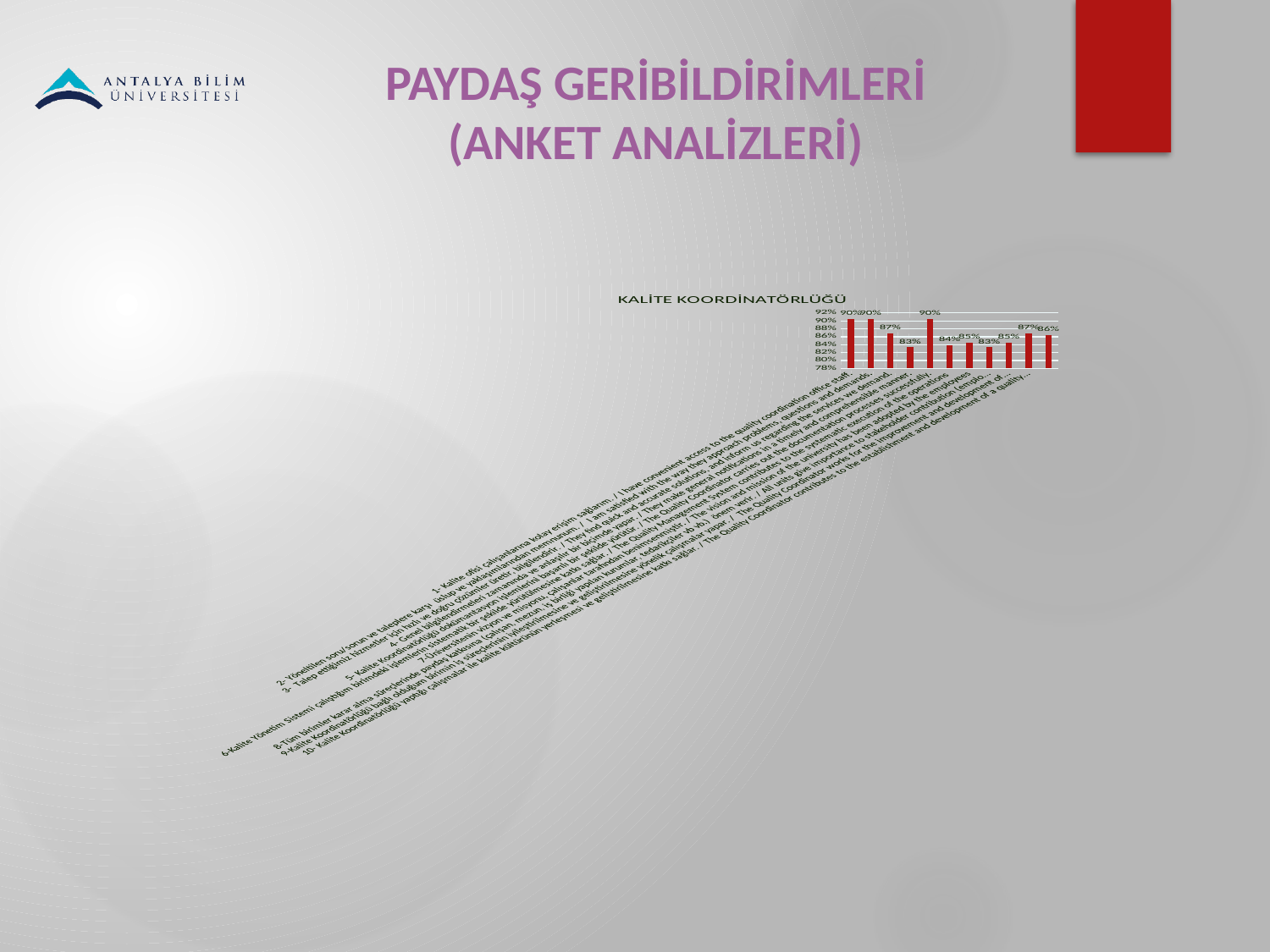
What is the highest tick value shown on the vertical axis of the chart? 92% What is the difference between the highest bar value (90%) and the lowest bar value (83%) in the chart? 7 percentage points Which is larger, the value of the first bar or the value of the last bar? the first bar Are all the bar values in the chart greater or less than 80%? greater What is the lowest value shown by any bar in the chart? 83% What is the highest value shown by any bar in the chart? 90% What is the value of the first (leftmost) bar in the chart? 90% What is the value of the last (rightmost) bar in the chart? 86% Is the value of the first bar greater or less than 88%? greater What is the title of the chart on the slide? KALİTE KOORDİNATÖRLÜĞÜ What kind of chart is shown on the slide? bar chart